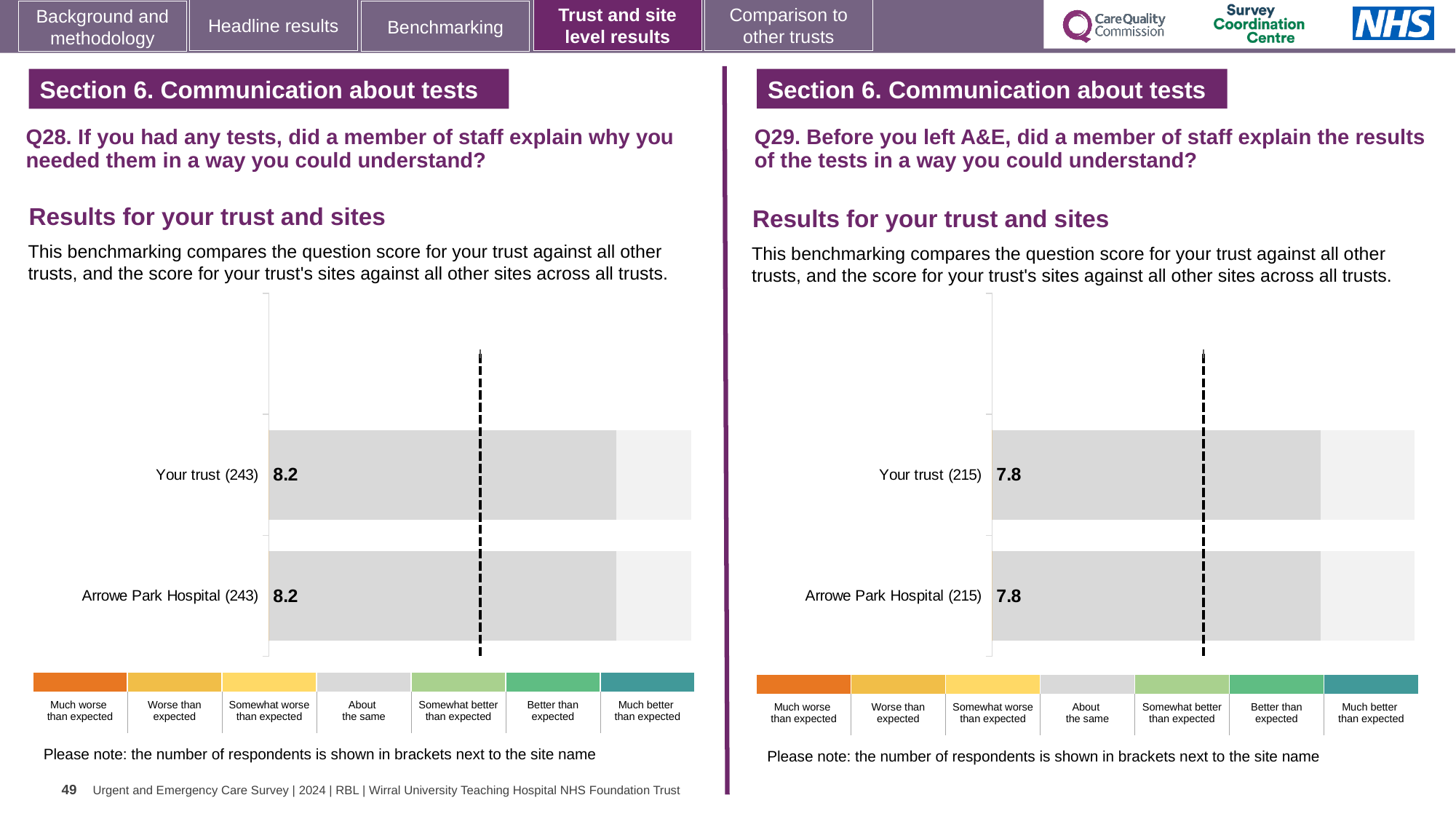
In the Q29 chart on the right, how many respondents are shown in brackets next to Arrowe Park Hospital? 215 How many bars are plotted in the Q28 chart on the left? 2 In the Q28 chart on the left, what is the score for Arrowe Park Hospital? 8.2 In the Q29 chart on the right, what is the difference between the score for Your trust and the score for Arrowe Park Hospital? 0 In the Q28 chart on the left, what is the difference between the score for Your trust and the score for Arrowe Park Hospital? 0 In the Q29 chart on the right, what is the score for Your trust? 7.8 Is the score for Your trust in the Q28 chart on the left larger or smaller than the score for Your trust in the Q29 chart on the right? Larger How many bars are plotted in the Q29 chart on the right? 2 In the Q28 chart on the left, how many respondents are shown in brackets next to Your trust? 243 What kind of chart is used for the Q28 results on the left? Bar chart In the Q28 chart on the left, what is the score for Your trust? 8.2 In the Q29 chart on the right, what is the score for Arrowe Park Hospital? 7.8